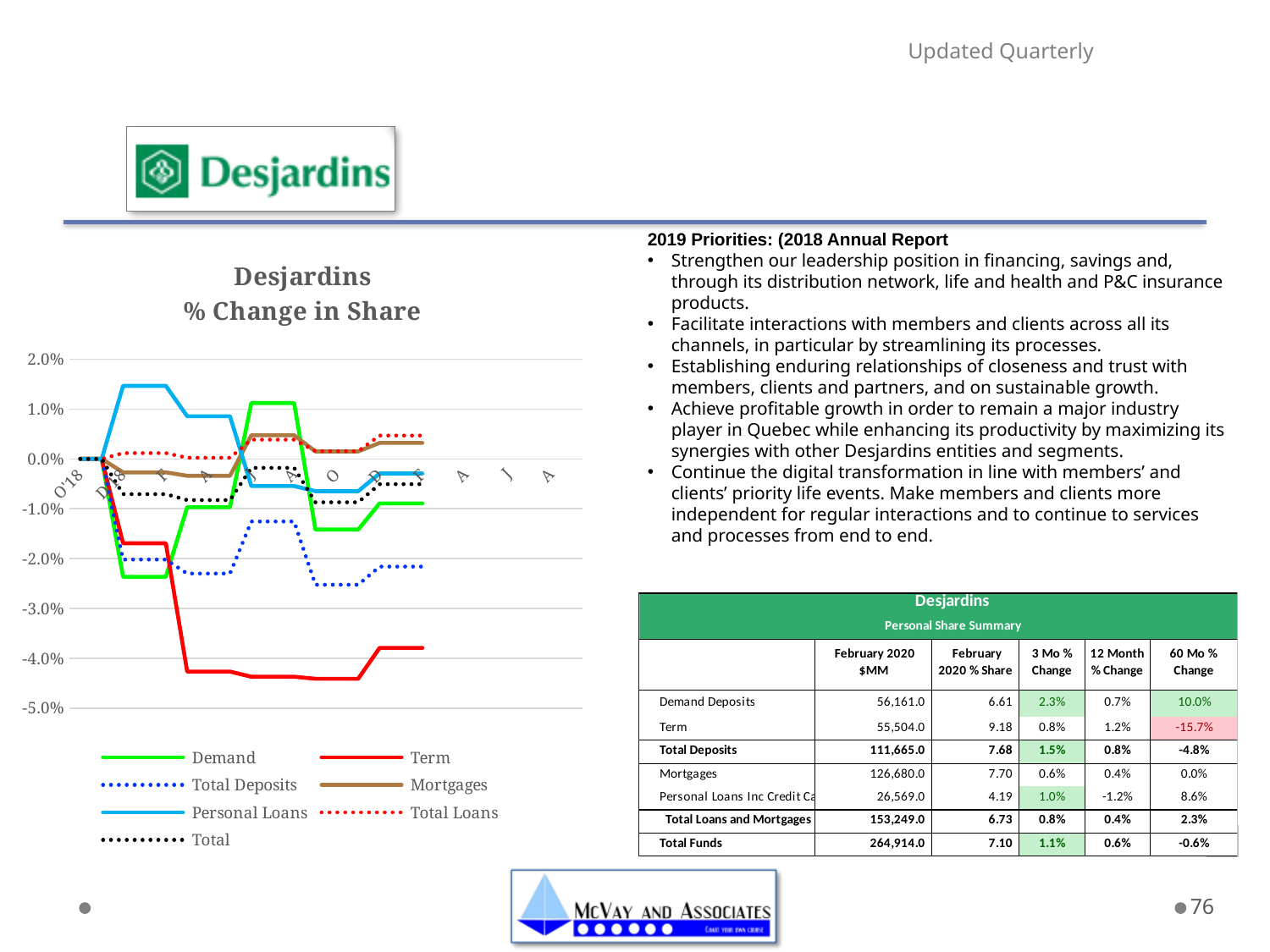
At the end of the plotted period, which is larger in the "% Change in Share" chart: the Mortgages value or the Term value? Mortgages Is the lowest value of the Demand series in the "% Change in Share" chart greater or less than -2.0%? less What colour is the Term line in the "% Change in Share" chart? Red How many series does the legend of the "% Change in Share" chart list? 7 Is the lowest value of the Total Deposits series in the "% Change in Share" chart greater or less than -2.0%? less Which series in the "% Change in Share" chart reaches the highest value? Personal Loans Which series in the "% Change in Share" chart reaches the lowest value? Term Does the Term series in the "% Change in Share" chart rise or fall overall from the start to the end of the x axis? Fall Is the highest value of the Personal Loans series in the "% Change in Share" chart greater or less than 1.0%? greater What kind of chart is shown under the title "Desjardins % Change in Share"? Line chart What is the lowest tick value shown on the y axis of the "% Change in Share" chart? -5.0%